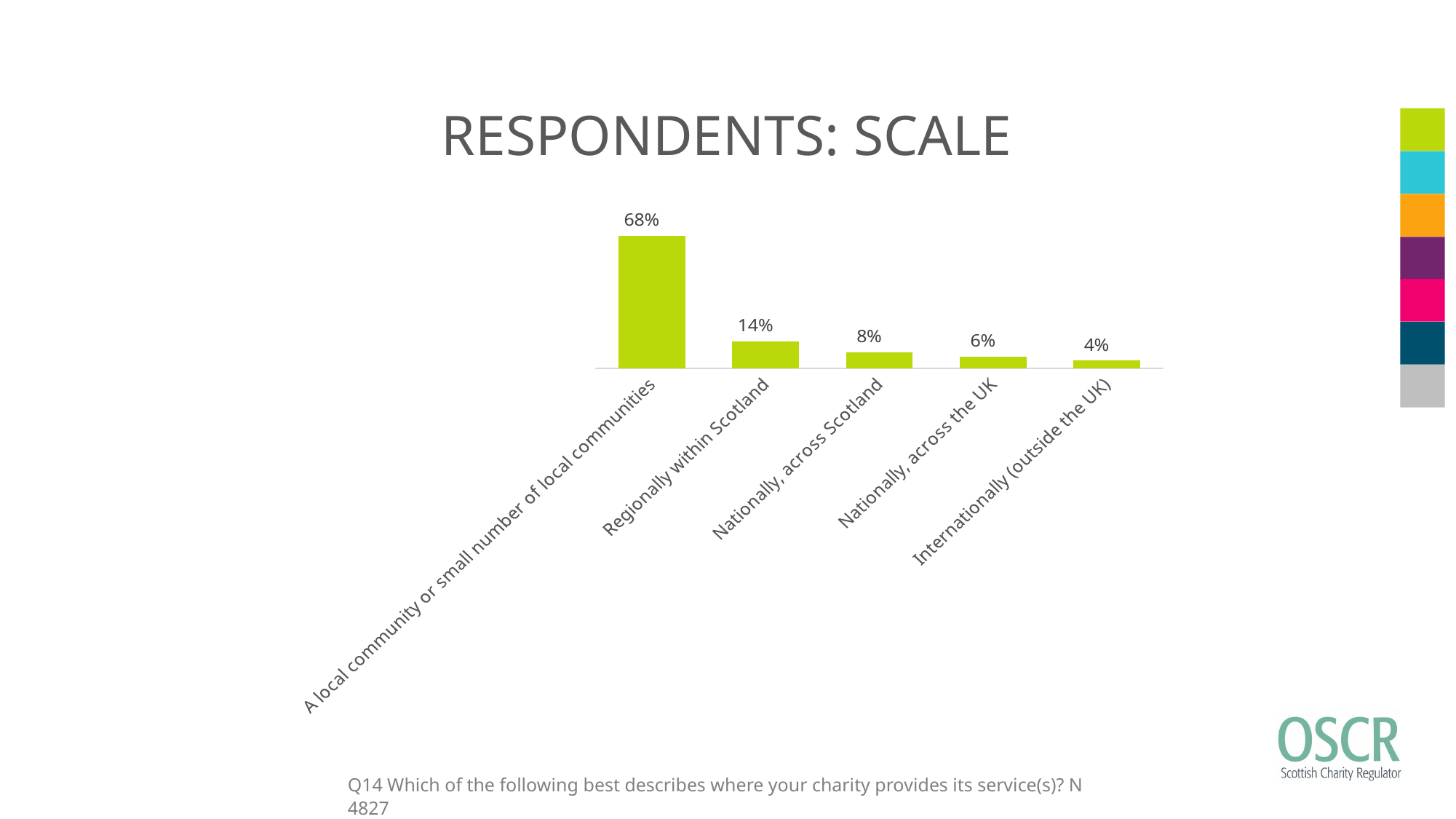
Do the values rise or fall from left to right along the x axis? Fall Which is larger: 'Nationally, across the UK' or 'Internationally (outside the UK)'? Nationally, across the UK What is the value for 'Nationally, across Scotland'? 8% Which category has the highest value? A local community or small number of local communities What is the value for 'Regionally within Scotland'? 14% Which category has the lowest value? Internationally (outside the UK) What is the difference between 'Nationally, across Scotland' and 'Nationally, across the UK'? 2% What is the value for 'Internationally (outside the UK)'? 4% How many categories are shown in the chart? 5 What is the difference between the values for 'A local community or small number of local communities' and 'Regionally within Scotland'? 54% What percentage of respondents provide services to a local community or small number of local communities? 68% What kind of chart is shown on the slide? Bar chart